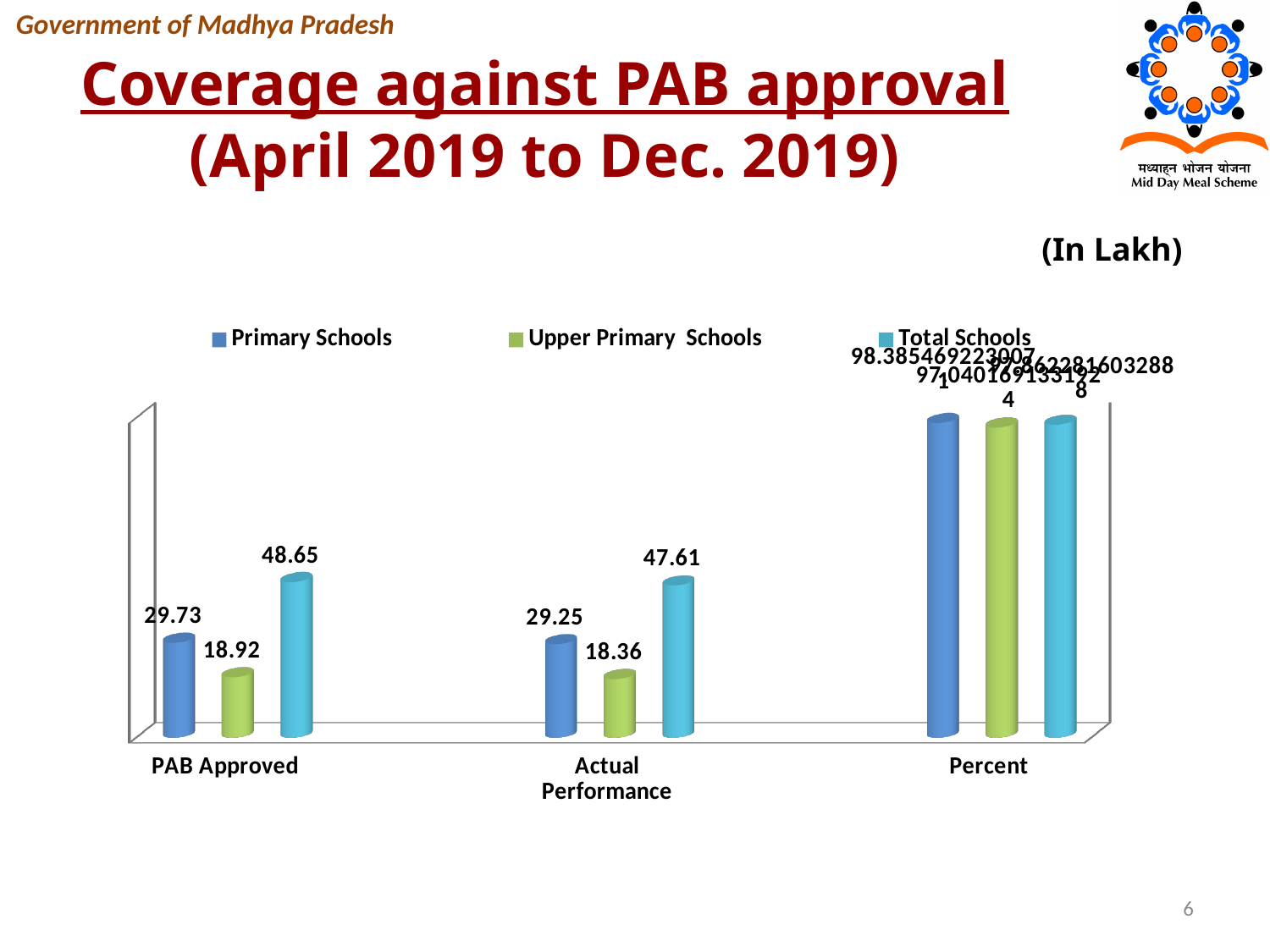
What is the value for Total Schools in the PAB Approved category? 48.65 What is the value for Total Schools in the Actual Performance category? 47.61 What kind of chart is shown on the slide? Bar chart Which series has the lowest value in the PAB Approved category? Upper Primary Schools Which series has the highest value in the Actual Performance category? Total Schools What is the difference between the Total Schools values for PAB Approved and Actual Performance? 1.04 How many categories are shown on the x axis? 3 How many series does the legend list? 3 What is the value for Primary Schools in the PAB Approved category? 29.73 Which is larger: the Primary Schools value for PAB Approved or for Actual Performance? PAB Approved What is the difference between the Primary Schools and Upper Primary Schools values in the PAB Approved category? 10.81 What is the value for Upper Primary Schools in the Actual Performance category? 18.36